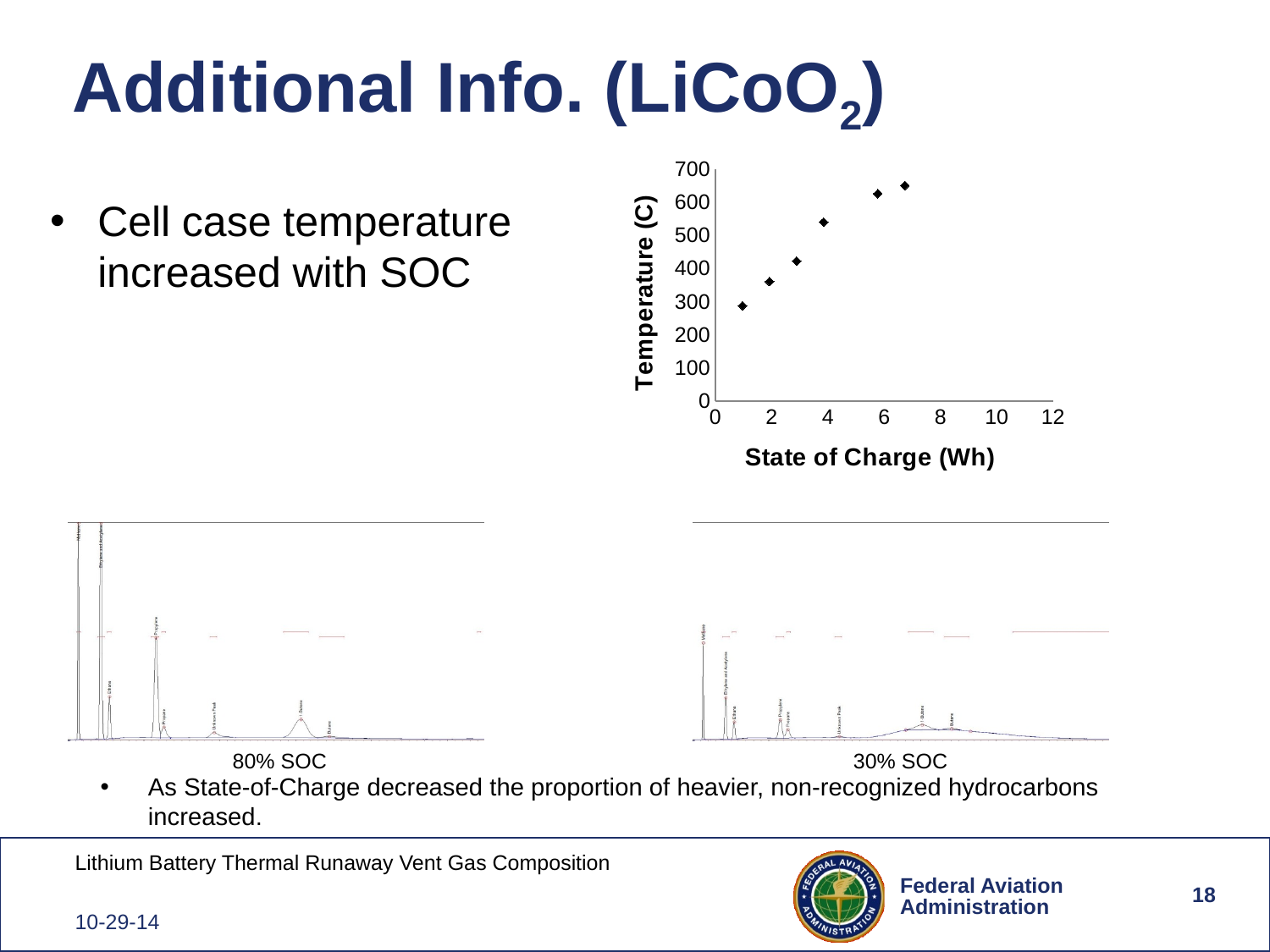
In the scatter chart, is the temperature for the point at about 6 Wh greater or less than 500? greater In the scatter chart, what is the label of the horizontal axis? State of Charge (Wh) In the scatter chart, is the temperature for the point at about 4 Wh greater or less than 500? greater In the scatter chart, is the temperature for the point at about 7 Wh greater or less than 600? greater In the scatter chart, what is the highest value shown on the vertical axis? 700 How many data points are plotted in the scatter chart? 6 In the scatter chart, what is the label of the vertical axis? Temperature (C) What kind of chart is the chart in the upper right of the slide? scatter chart In the scatter chart, do the temperature values rise or fall as State of Charge increases? rise In the scatter chart, which point has the highest temperature: the one at about 1 Wh or the one at about 7 Wh? the one at about 7 Wh